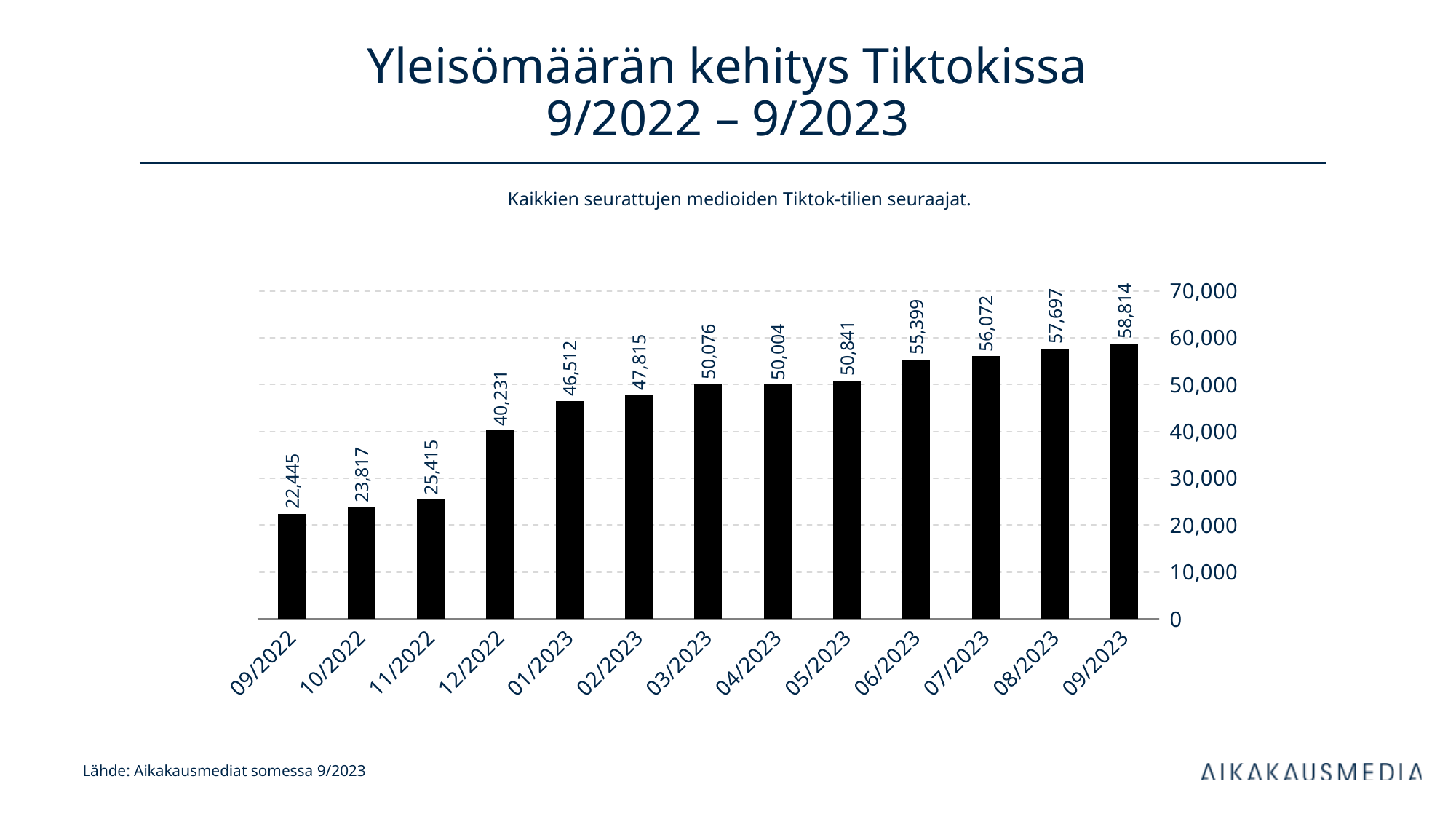
What is the difference between the values for 12/2022 and 11/2022? 14,816 What is the value for 05/2023? 50,841 What is the value for 12/2022? 40,231 What kind of chart is shown on the slide? bar chart Which month has the lowest value? 09/2022 What is the difference between the values for 09/2023 and 09/2022? 36,369 Is the value for 06/2023 greater or less than 50,000? greater How many months are shown on the x axis? 13 Which is larger, the value for 03/2023 or the value for 04/2023? 03/2023 Do the values generally rise or fall from 09/2022 to 09/2023? rise Which month has the highest value? 09/2023 What is the value for 09/2022? 22,445